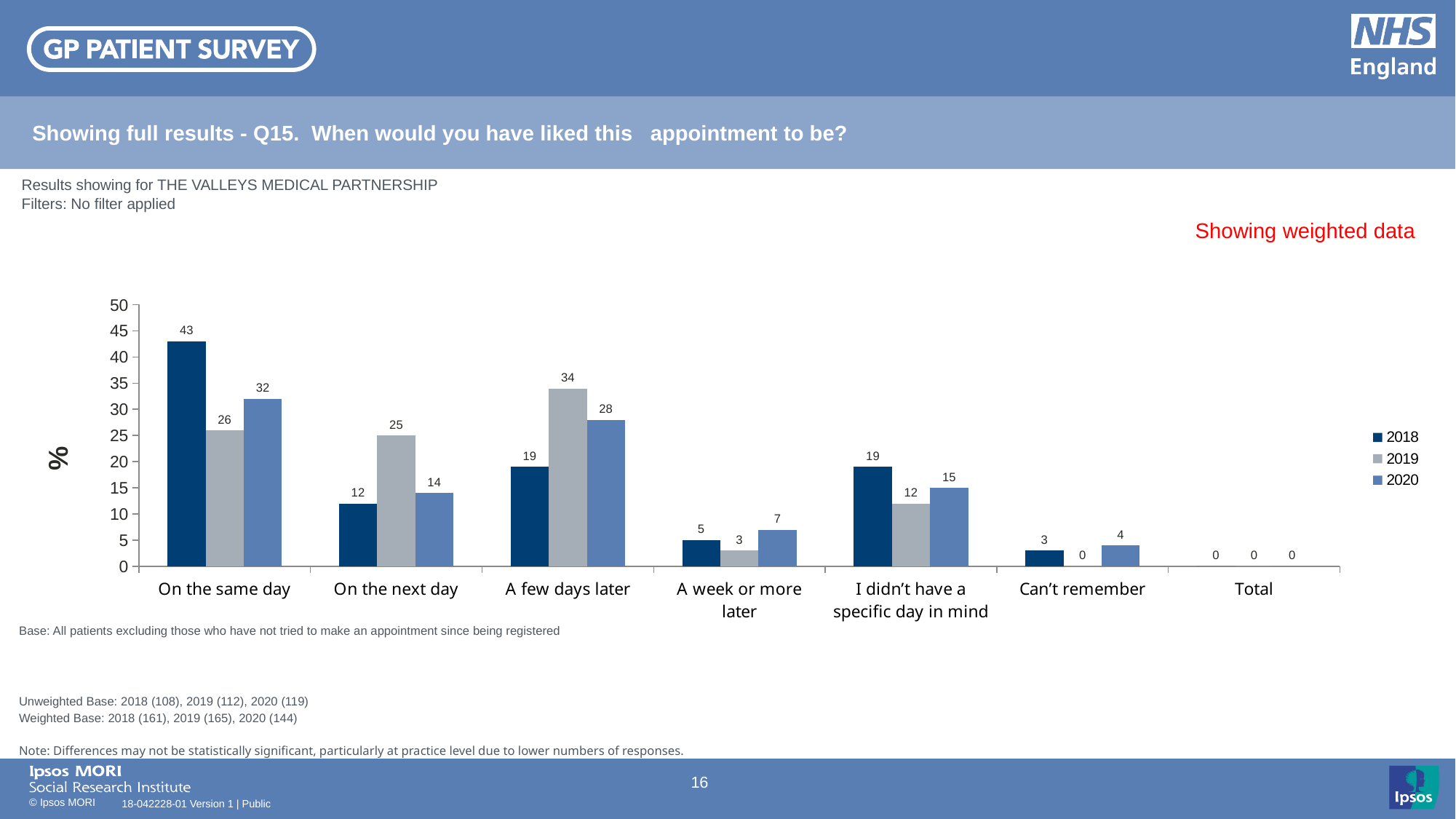
What is the 2020 value for 'I didn't have a specific day in mind'? 15 Which category has the highest 2018 value? On the same day Which category has the highest 2019 value? A few days later Which is larger for 'On the next day': the 2019 value or the 2020 value? 2019 What is the 2019 value for 'Can't remember'? 0 What is the 2019 value for 'A few days later'? 34 What is the 2018 value for 'On the same day'? 43 How many series does the legend list? 3 What label is shown on the y axis? % How many categories are shown on the x axis? 7 What kind of chart is shown on the slide? Bar chart What is the difference between the 2018 and 2020 values for 'On the same day'? 11